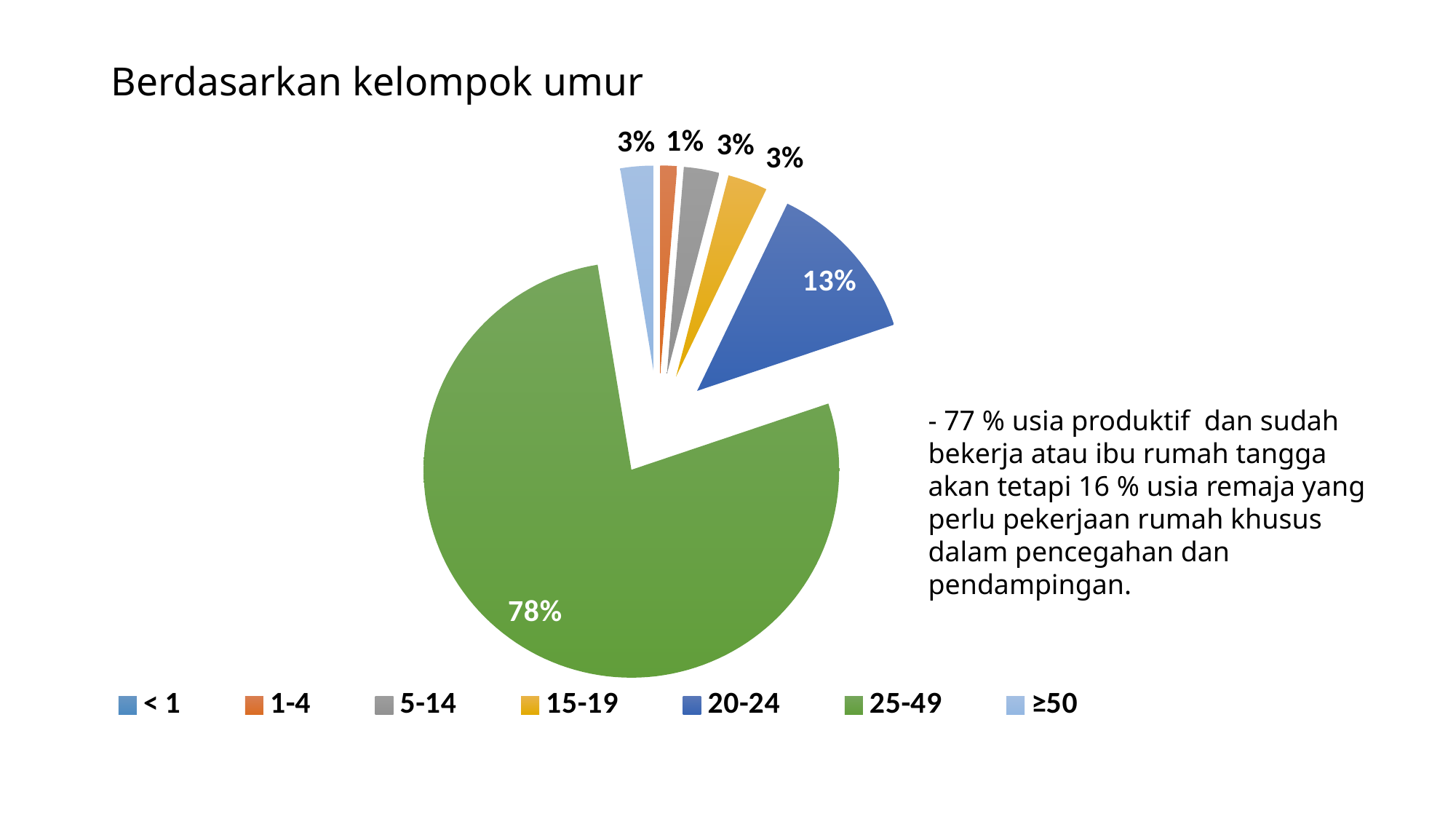
Which age group has the largest slice of the pie? 25-49 What percentage does the 1-4 age group slice show? 1% What type of chart is shown on the slide? pie chart How many age groups are listed in the legend? 7 What is the title of the slide above the chart? Berdasarkan kelompok umur What percentage does the 20-24 age group slice show? 13% What is the difference in percentage points between the 25-49 slice and the 20-24 slice? 65 What percentage does the ≥50 age group slice show? 3% Among the slices with a printed percentage, which age group has the smallest share? 1-4 Which slice is larger, 20-24 or 15-19? 20-24 What percentage does the 25-49 age group slice show? 78% What percentage does the 5-14 age group slice show? 3%